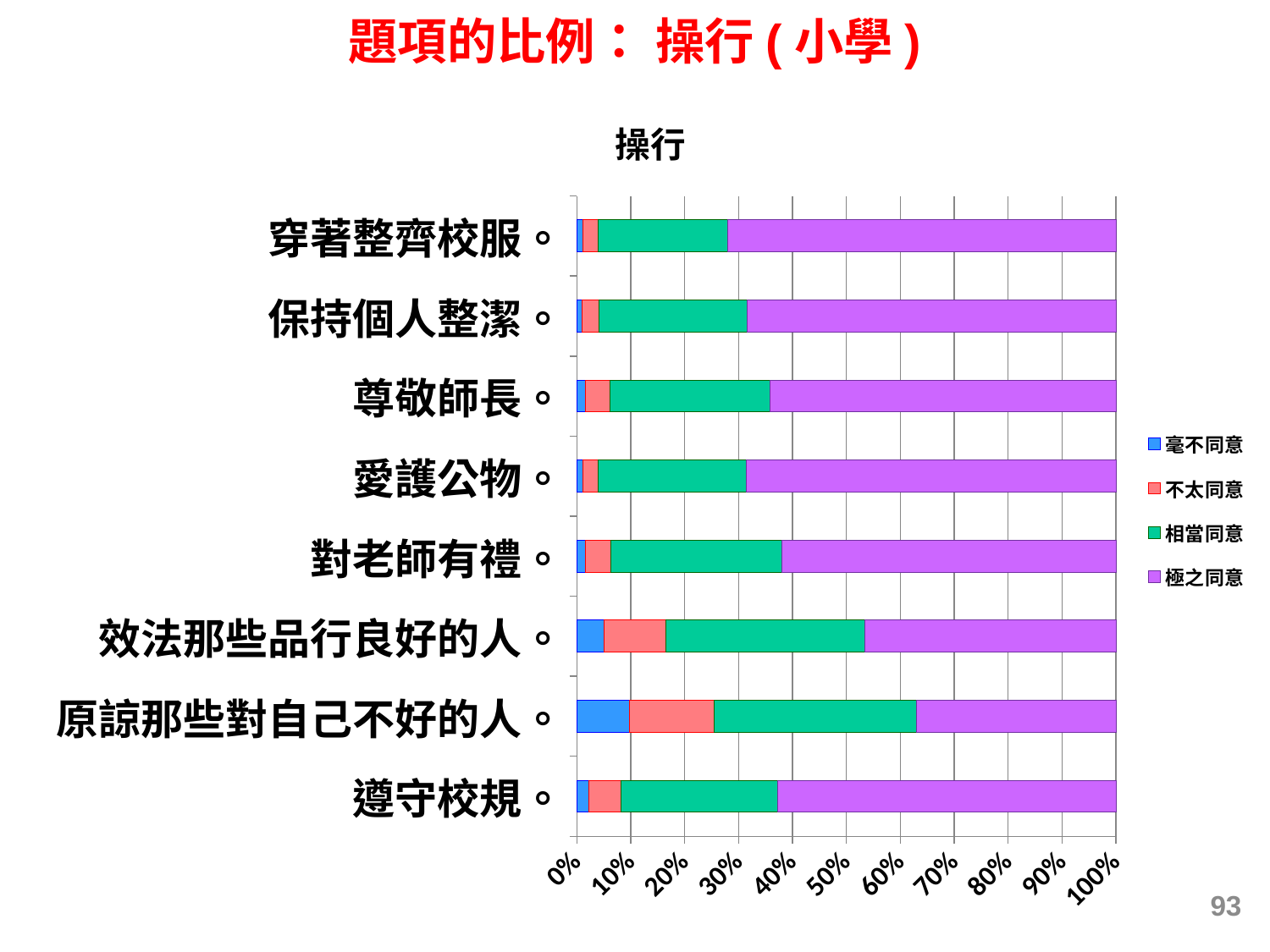
Is the 毫不同意 value for 原諒那些對自己不好的人 greater or less than 20%? less Which legend entry is shown in purple? 極之同意 Is the 極之同意 value for 原諒那些對自己不好的人 greater or less than 50%? less What is the title of the chart? 操行 Is the 毫不同意 segment larger for 原諒那些對自己不好的人 or for 效法那些品行良好的人? 原諒那些對自己不好的人。 How many categories (items) are plotted on the chart? 8 Which category has the largest 毫不同意 segment? 原諒那些對自己不好的人。 How many series does the legend list? 4 Which category has the smallest 極之同意 segment? 原諒那些對自己不好的人。 Is the 相當同意 value for 效法那些品行良好的人 greater or less than 20%? greater What kind of chart is shown on the slide? Stacked bar chart